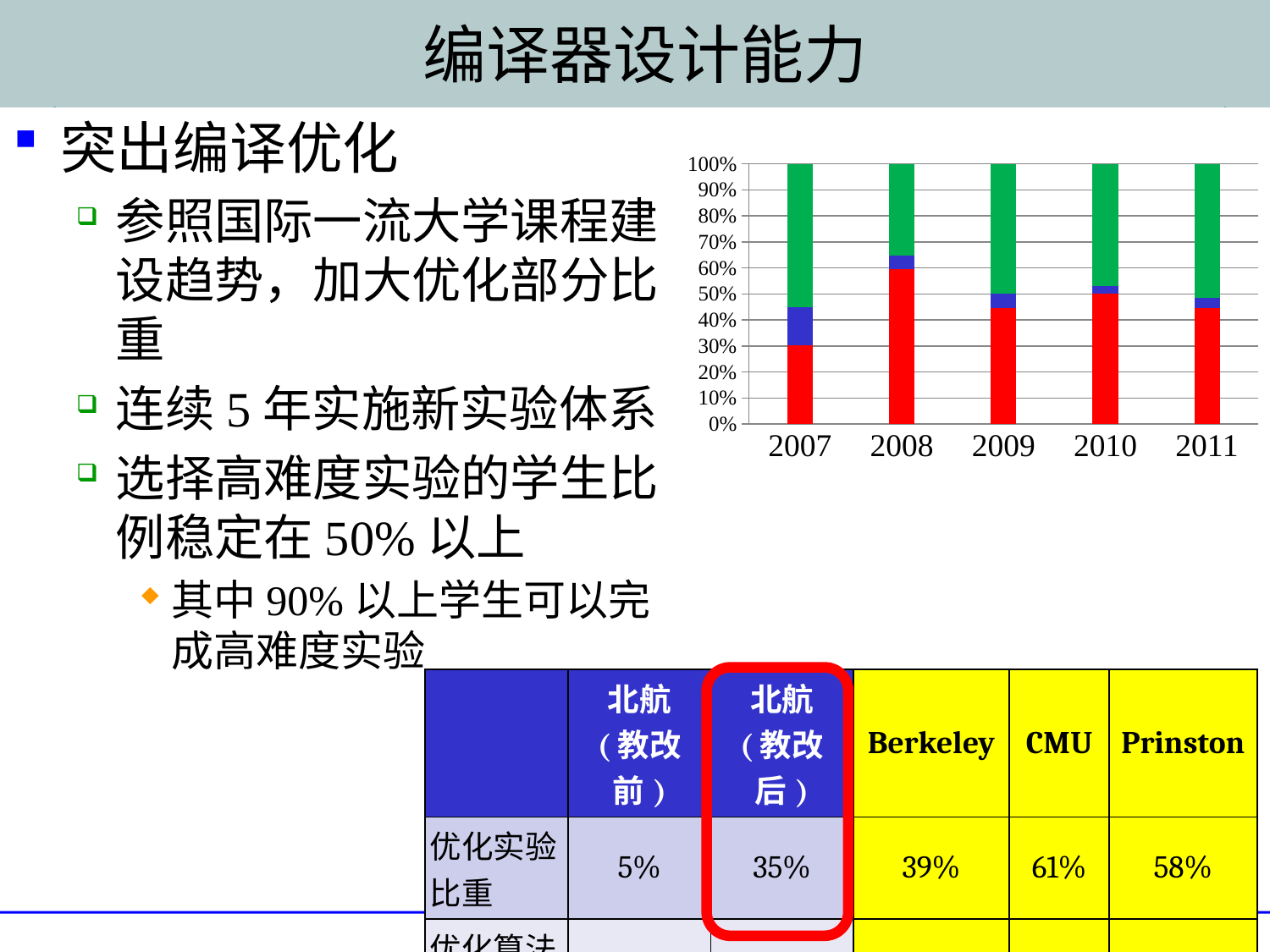
Which year has the largest red segment in the chart? 2008 Which year has the largest blue segment in the chart? 2007 What kind of chart is shown on the slide? bar chart Does the red segment rise or fall from 2007 to 2008? rise What is the highest value shown on the chart's y axis? 100% Is the green segment for 2007 greater or less than 40%? greater Is the red segment for 2008 greater or less than 50%? greater Which year has the smallest red segment in the chart? 2007 How many years are shown on the x axis of the chart? 5 Is the red segment for 2007 greater or less than 40%? less Which year has a larger red segment, 2007 or 2008? 2008